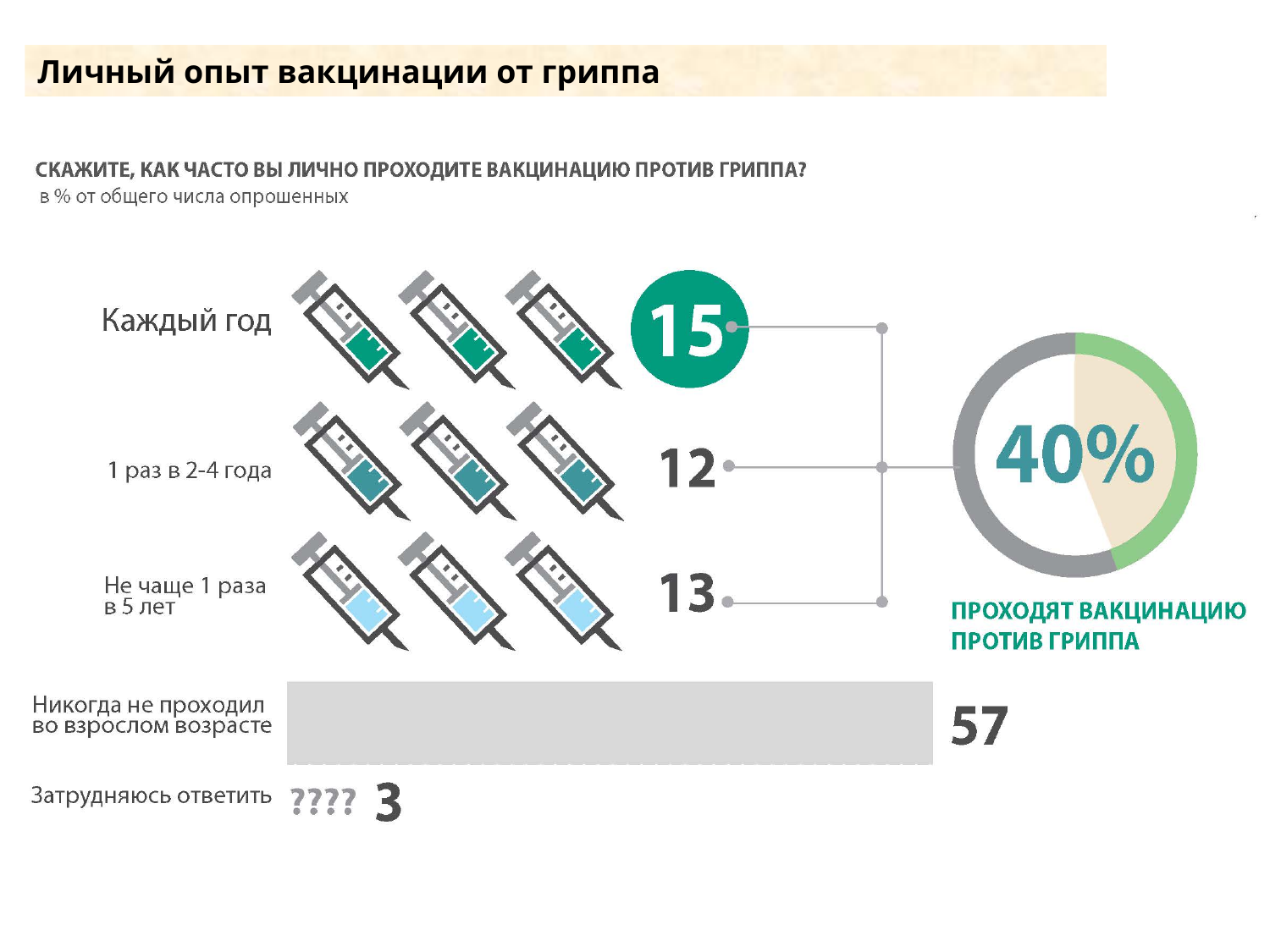
How many answer options are shown in the chart? 5 What is the difference between the values for "Никогда не проходил во взрослом возрасте" and "Каждый год"? 42 Which is larger: the value for "Каждый год" or for "1 раз в 2-4 года"? Каждый год Which answer option has the highest value? Никогда не проходил во взрослом возрасте What is the value for "Не чаще 1 раза в 5 лет"? 13 What is the total of the three vaccination-frequency options ("Каждый год", "1 раз в 2-4 года", "Не чаще 1 раза в 5 лет")? 40 What percentage of respondents answered "Никогда не проходил во взрослом возрасте"? 57 What is the combined share of respondents who get vaccinated against flu, as shown in the donut chart? 40% Which answer option has the lowest value? Затрудняюсь ответить What is the value for "Затрудняюсь ответить"? 3 What percentage of respondents answered "Каждый год"? 15 What is the value for "1 раз в 2-4 года"? 12